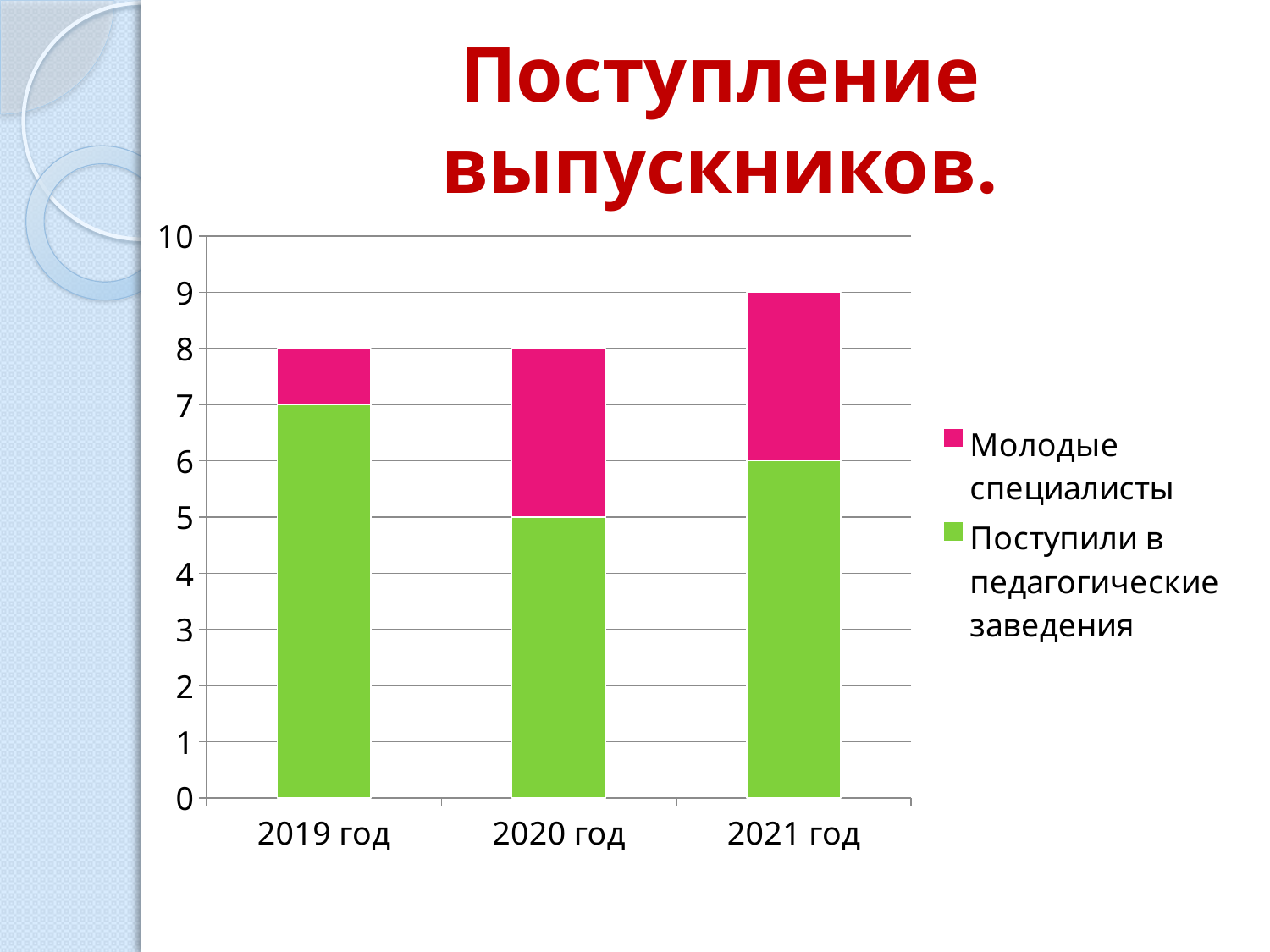
Which year has the highest total stacked bar? 2021 год What is the value of 'Поступили в педагогические заведения' for 2019 год? 7 How many series does the legend list? 2 What is the total height of the stacked bar for 2021 год? 9 What is the value of 'Поступили в педагогические заведения' for 2021 год? 6 What is the value of 'Поступили в педагогические заведения' for 2020 год? 5 What is the value of 'Молодые специалисты' for 2020 год (the top segment of the stacked bar)? 3 What kind of chart is shown on the slide? Stacked bar chart How many years are shown on the x axis? 3 Which colour represents 'Молодые специалисты' in the legend? Pink What is the total height of the stacked bar for 2019 год? 8 Which year has the lowest value for 'Поступили в педагогические заведения'? 2020 год